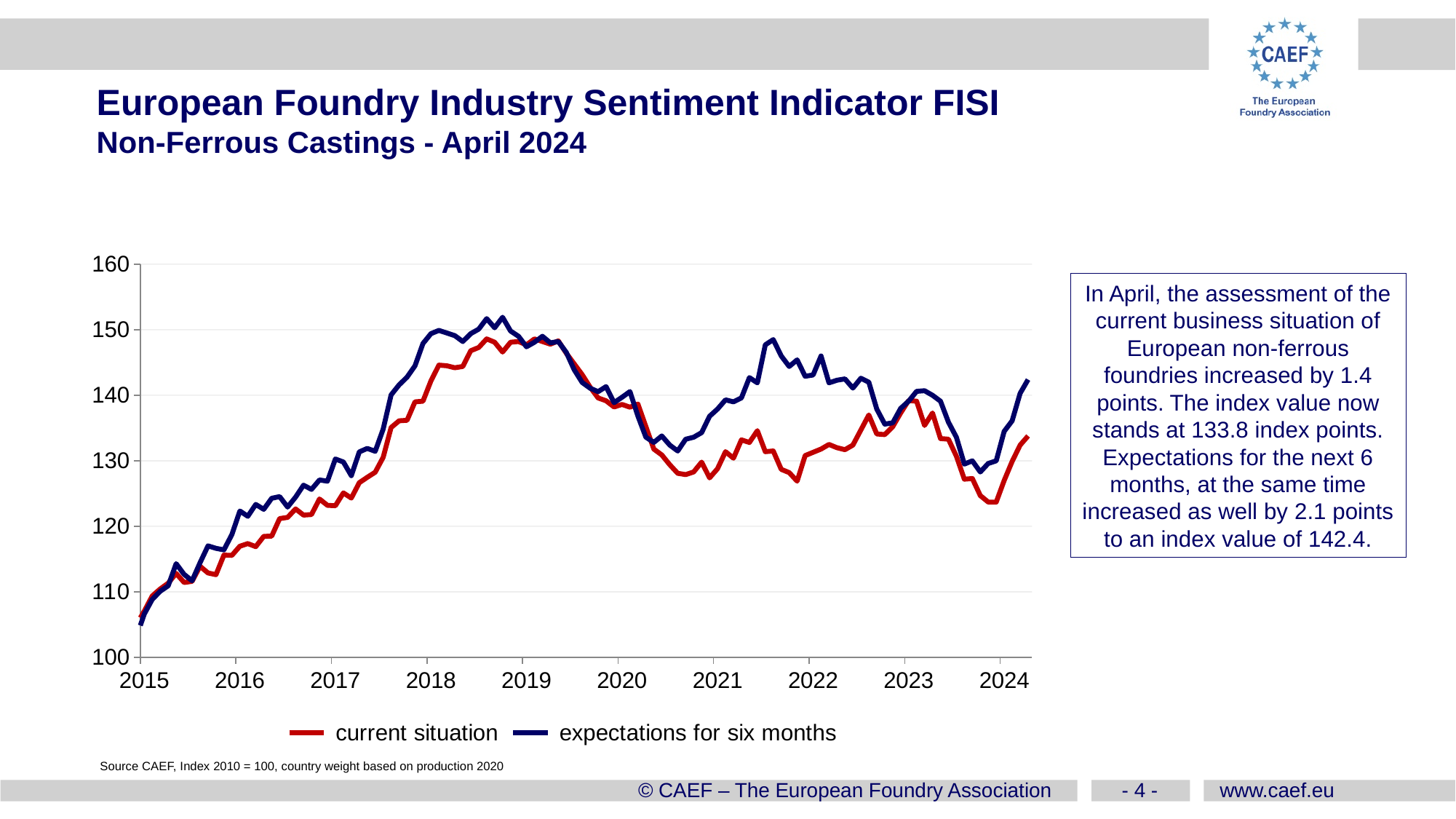
In April 2024, which series has the higher value: current situation or expectations for six months? expectations for six months What type of chart is shown on the slide? line chart How many series does the chart legend list? 2 Is the value of the current situation series at the end of 2023 greater or less than 130? less How do the values of both series change from 2015 to 2018? they rise What are the two series named in the chart legend? current situation; expectations for six months What is the index value of the current situation series in April 2024? 133.8 By how many points did the expectations for six months index increase in April 2024? 2.1 What is the difference between the expectations for six months value and the current situation value in April 2024? 8.6 Is the value of the expectations for six months series at the start of 2015 greater or less than 110? less By how many points did the current situation index increase in April 2024? 1.4 What is the index value of the expectations for six months series in April 2024? 142.4